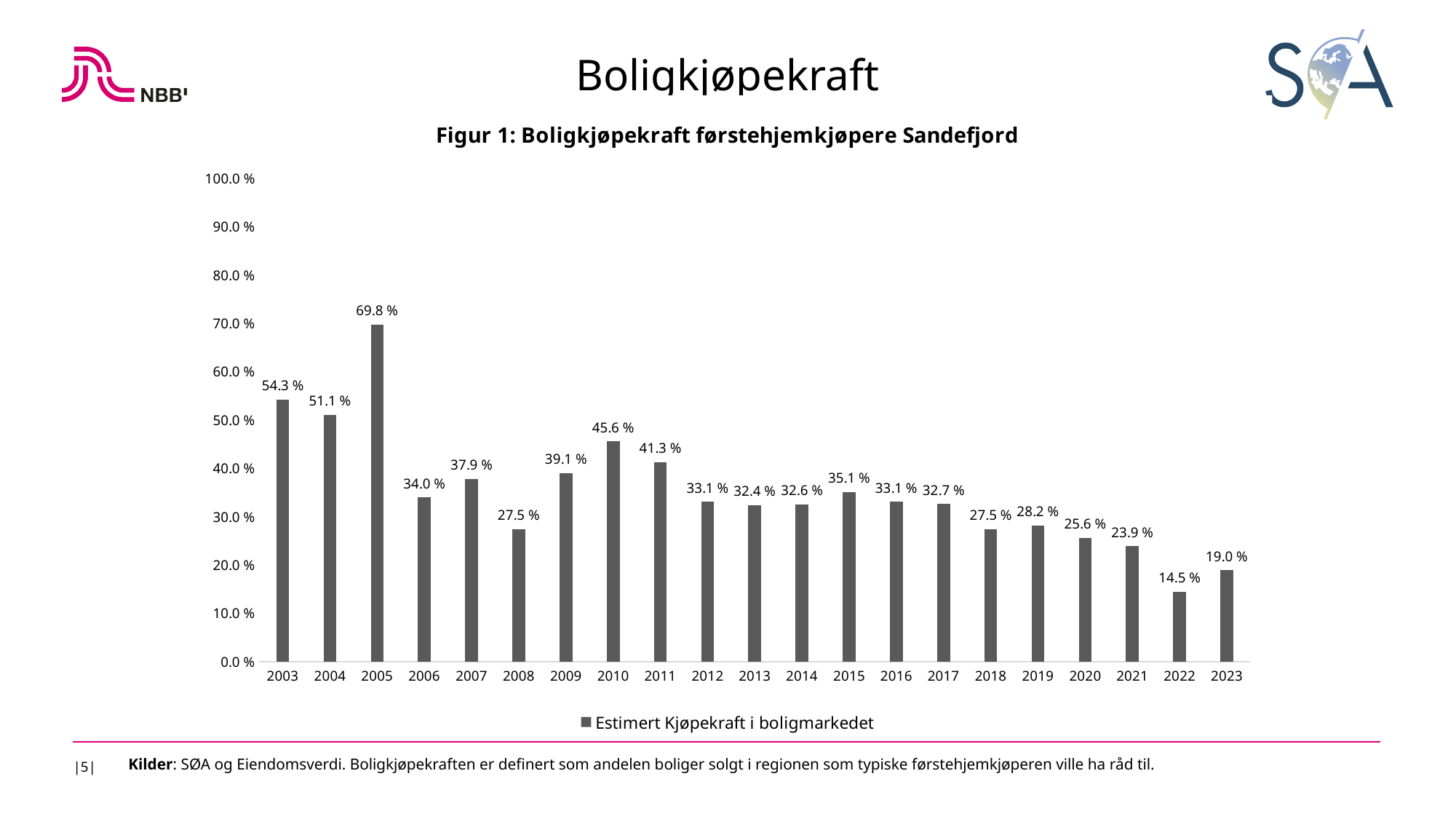
Which year has the highest value? 2005 What kind of chart is shown? bar chart Which year has the lowest value? 2022 How many series does the legend list? 1 What is the difference between the values for 2003 and 2023? 35.3 % Is the value for 2008 greater or less than 30.0 %? less What is the value for 2005? 69.8 % What is the value for 2010? 45.6 % What is the value for 2022? 14.5 % What is the legend entry for the series? Estimert Kjøpekraft i boligmarkedet Which is larger, the value for 2009 or the value for 2011? 2011 How many years are shown on the x axis? 21